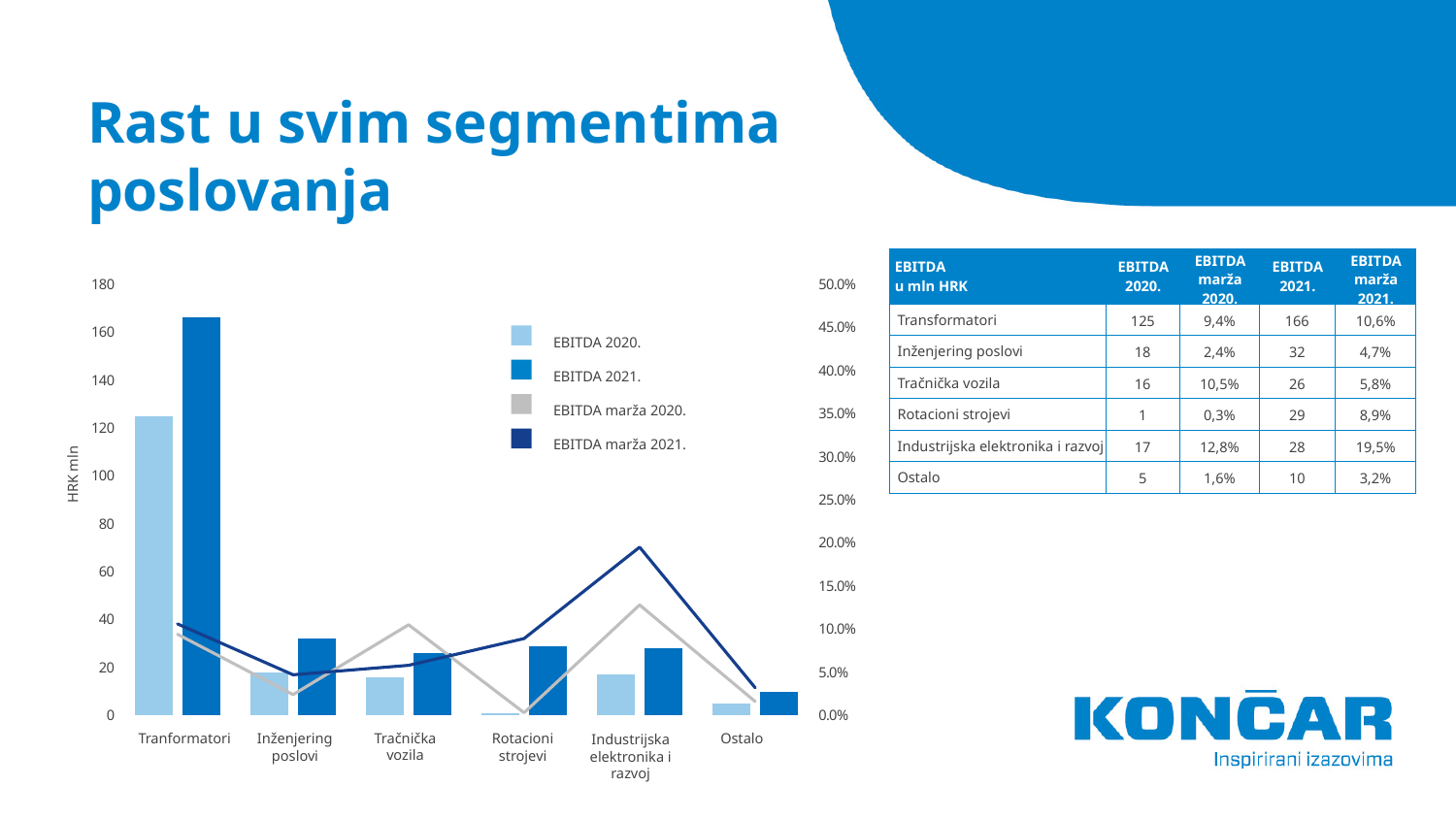
What is the EBITDA marža 2021 for Industrijska elektronika i razvoj? 19,5% Which is larger for Inženjering poslovi: EBITDA 2020 or EBITDA 2021? EBITDA 2021 Is the EBITDA 2021 bar for Transformatori greater or less than 160? greater Does the EBITDA marža 2021 line rise or fall from Industrijska elektronika i razvoj to Ostalo? fall How many business segments are shown on the x axis of the chart? 6 What is the EBITDA 2021 value for Transformatori? 166 How many series does the chart legend list? 4 Which segment has the lowest EBITDA 2020 bar? Rotacioni strojevi What is the difference between EBITDA 2021 and EBITDA 2020 for Transformatori? 41 Which segment has the highest EBITDA 2021 bar? Transformatori What type of chart is shown on the slide? Combination bar and line chart What unit is shown on the left vertical axis of the chart? HRK mln